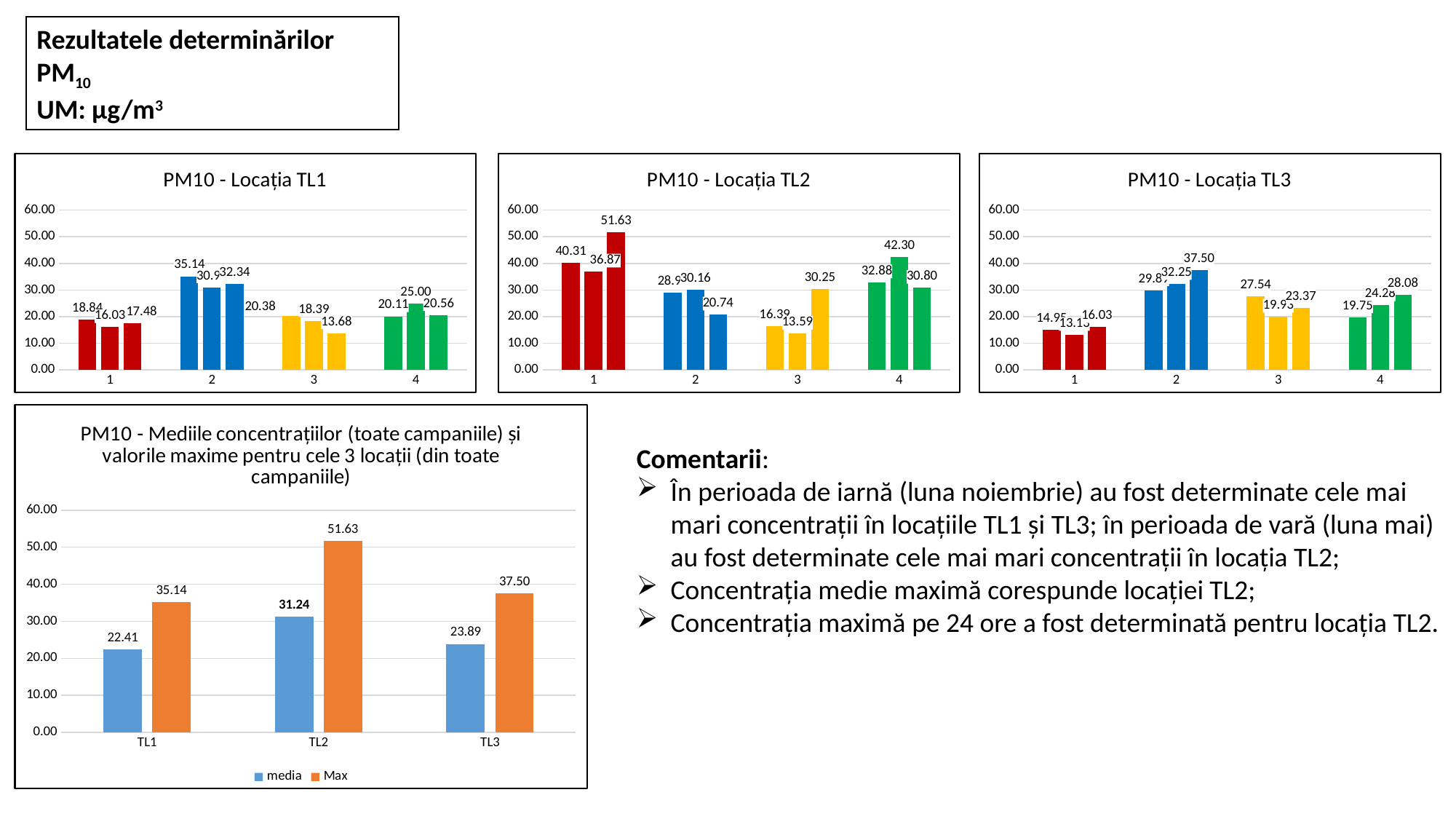
In the chart 'PM10 - Mediile concentrațiilor ... pentru cele 3 locații', how many series does the legend list? 2 What type of chart is 'PM10 - Locația TL2'? Bar chart In the chart 'PM10 - Locația TL3', is the value of the tallest bar in group 2 greater or less than 30.00? greater In the chart 'PM10 - Locația TL2', what is the value of the tallest bar in group 4? 42.30 In the chart 'PM10 - Locația TL1', how many category groups are shown on the x axis? 4 In the chart 'PM10 - Mediile concentrațiilor ... pentru cele 3 locații', what are the legend entries? media, Max In the chart 'PM10 - Locația TL2', what is the highest value shown in group 1? 51.63 In the chart 'PM10 - Mediile concentrațiilor ... pentru cele 3 locații', what is the difference between the 'Max' and 'media' values for TL1? 12.73 In the chart 'PM10 - Mediile concentrațiilor ... pentru cele 3 locații', which location has the highest 'Max' value? TL2 In the chart 'PM10 - Mediile concentrațiilor ... pentru cele 3 locații', what is the 'media' value for TL2? 31.24 In the chart 'PM10 - Mediile concentrațiilor ... pentru cele 3 locații', what is the 'Max' value for TL3? 37.50 In the chart 'PM10 - Mediile concentrațiilor ... pentru cele 3 locații', which location has the lowest 'media' value? TL1